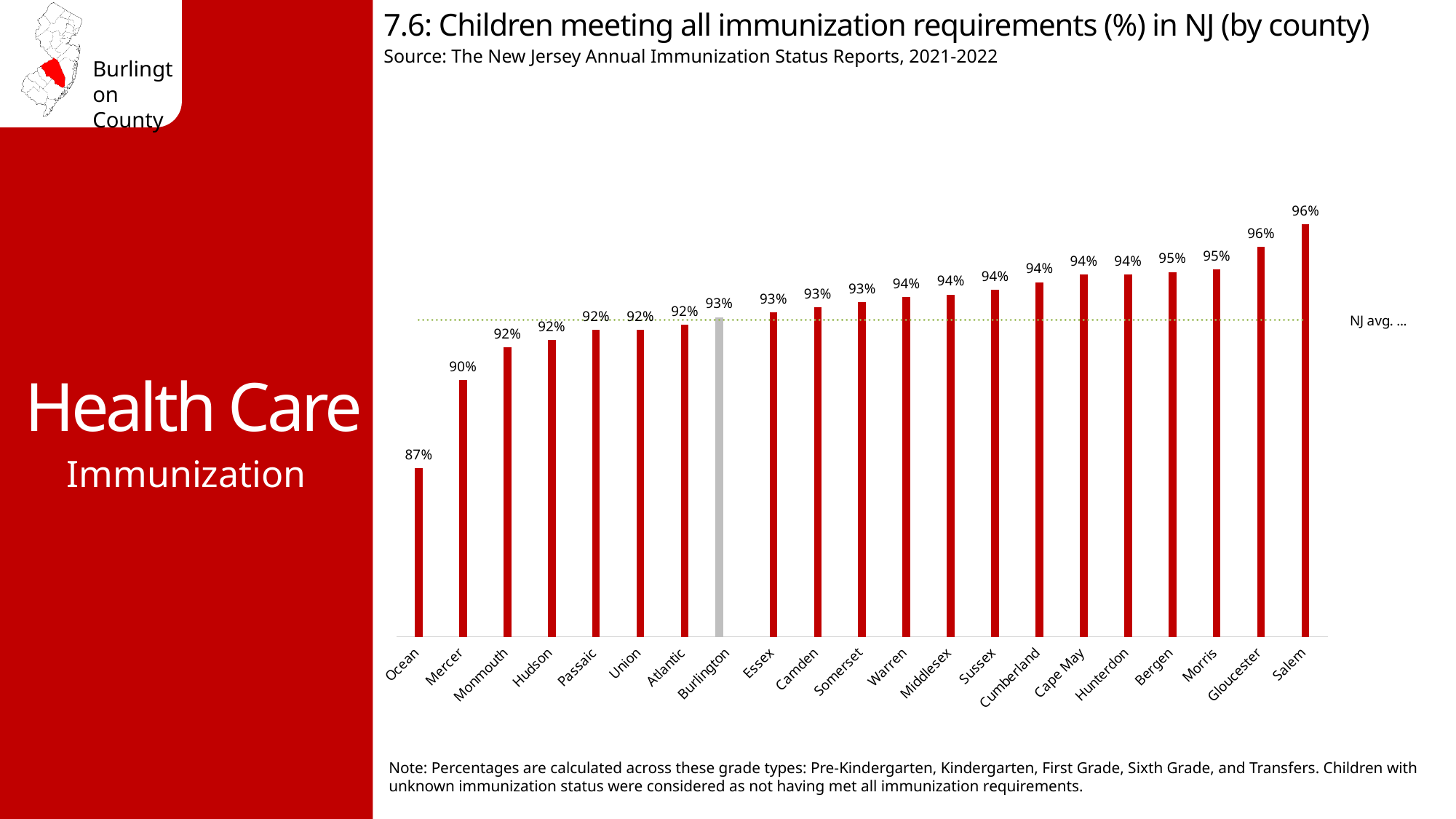
What is the value shown for Salem County? 96% What is the value shown for Ocean County? 87% Which has a higher value, Ocean or Mercer? Mercer What is the value shown for Mercer County? 90% What is the difference in percentage points between Burlington and Ocean? 6 percentage points What percentage of children in Burlington County met all immunization requirements? 93% Do the values rise or fall moving from left to right along the x axis? Rise How many counties are shown in the chart? 21 Which county has the tallest bar in the chart? Salem What type of chart is used on this slide? Bar chart Which county has the lowest percentage of children meeting all immunization requirements? Ocean What is the difference in percentage points between Salem and Ocean? 9 percentage points